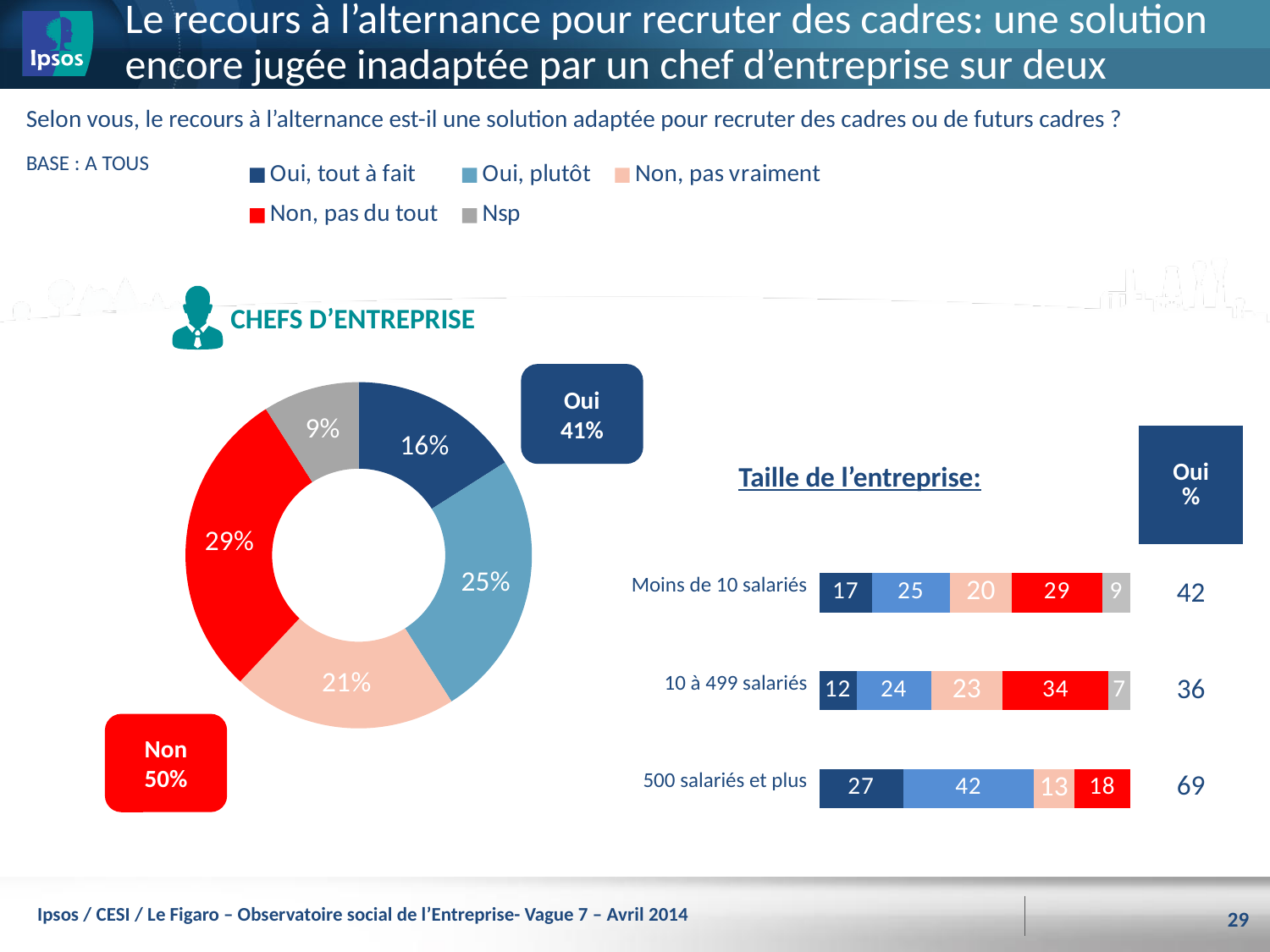
How many company-size categories are shown in the bar chart "Taille de l'entreprise"? 3 In the bar chart "Taille de l'entreprise", which company size has the highest "Oui %" total? 500 salariés et plus In the donut chart on the left, what share of chefs d'entreprise answered "Oui, tout à fait"? 16% In the bar chart "Taille de l'entreprise", what is the "Oui %" total for Moins de 10 salariés? 42 How many series does the legend at the top of the slide list? 5 In the bar chart "Taille de l'entreprise", what is the "Oui, plutôt" value for 500 salariés et plus? 42 In the donut chart on the left, what share answered "Non, pas du tout"? 29% In the bar chart "Taille de l'entreprise", is the "Oui, tout à fait" value larger for Moins de 10 salariés or for 10 à 499 salariés? Moins de 10 salariés In the donut chart on the left, what is the difference between the "Oui, plutôt" share and the "Non, pas vraiment" share? 4 points In the donut chart on the left, which response has the largest share? Non, pas du tout In the donut chart on the left, which response has the smallest share? Nsp In the bar chart "Taille de l'entreprise", what is the "Non, pas du tout" value for 10 à 499 salariés? 34